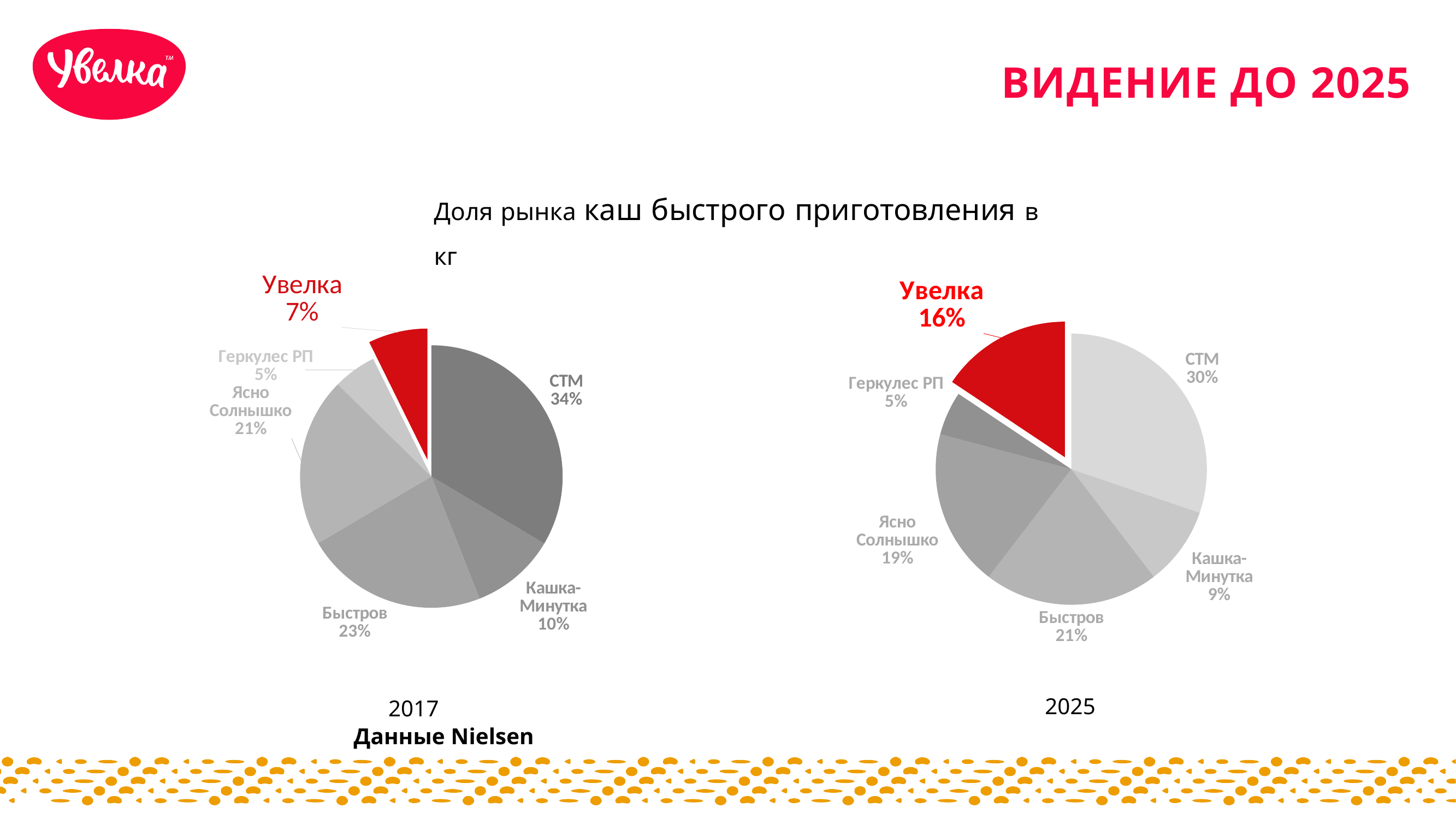
By how many percentage points does the share of Увелка in the 2025 chart exceed its share in the 2017 chart? 9 In the 2017 pie chart, what is the market share of Увелка? 7% How many slices does the 2017 pie chart have? 6 In the 2025 pie chart, which brand has the smallest share? Геркулес РП In the 2017 pie chart, what is the share of Быстров? 23% In the 2025 pie chart, what is the share of Кашка-Минутка? 9% In the 2017 pie chart, what is the difference in percentage points between СТМ and Ясно Солнышко? 13 In the 2017 pie chart, which brand has the largest share? СТМ Which slice is highlighted in red in both pie charts? Увелка What type of chart is used to show the market share for 2017 and 2025? Pie chart In the 2025 pie chart, which is larger: the share of СТМ or the share of Быстров? СТМ In the 2025 pie chart, what is the market share of Увелка? 16%